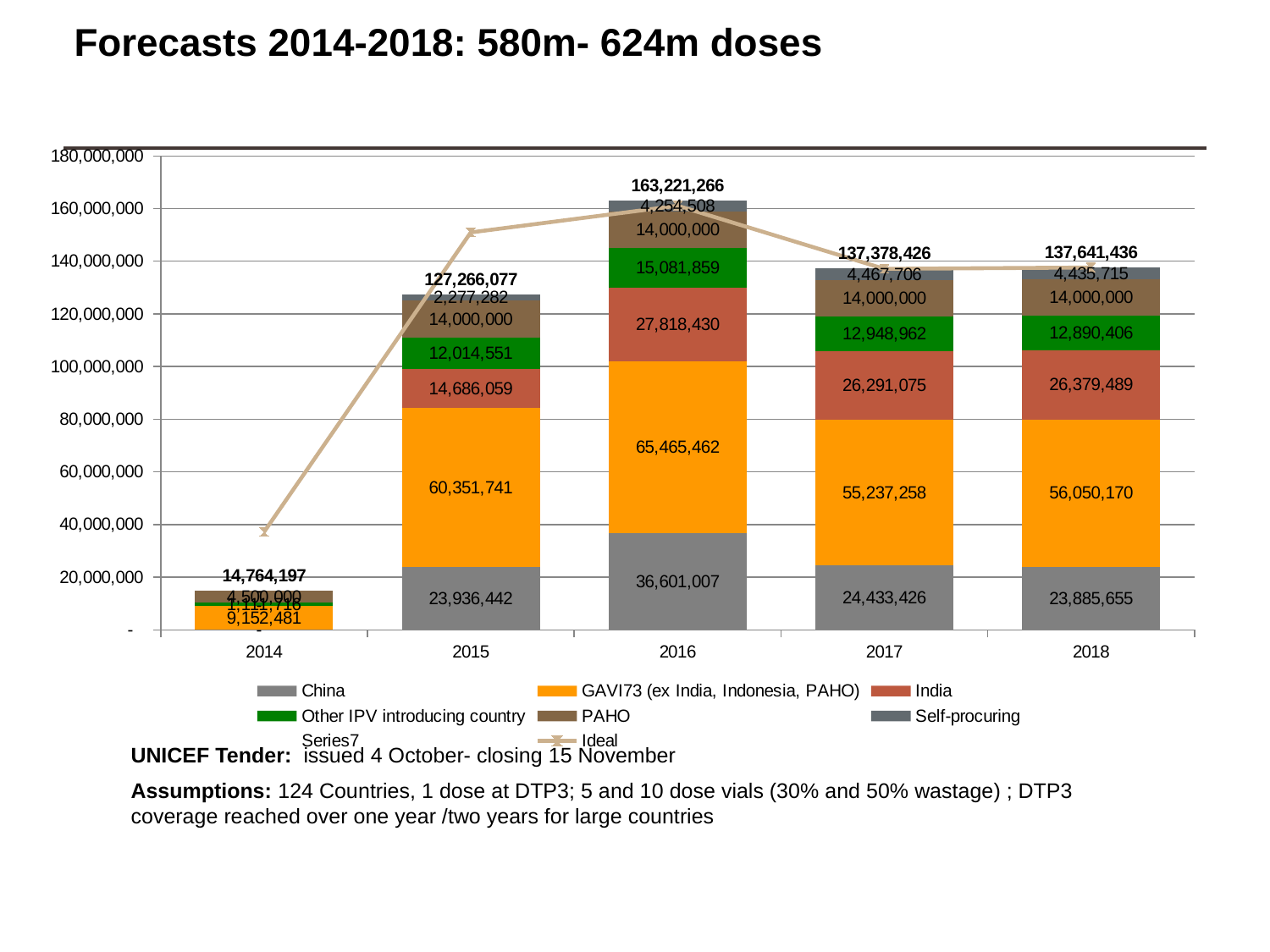
Is the total for 2015 greater or less than 120,000,000? greater What is the title of the slide? Forecasts 2014-2018: 580m- 624m doses What kind of chart is shown on the slide? combination stacked bar and line chart Which is larger, the GAVI73 (ex India, Indonesia, PAHO) value in 2017 or in 2018? 2018 Which year has the lowest total forecast of doses? 2014 What is the difference between the India value in 2016 and the India value in 2015? 13,132,371 What is the value for GAVI73 (ex India, Indonesia, PAHO) in 2015? 60,351,741 What is the value for China in 2016? 36,601,007 Which year has the highest total forecast of doses? 2016 What is the value for PAHO in 2018? 14,000,000 How many years are shown on the x axis of the chart? 5 What is the total of the stacked bar for 2017? 137,378,426